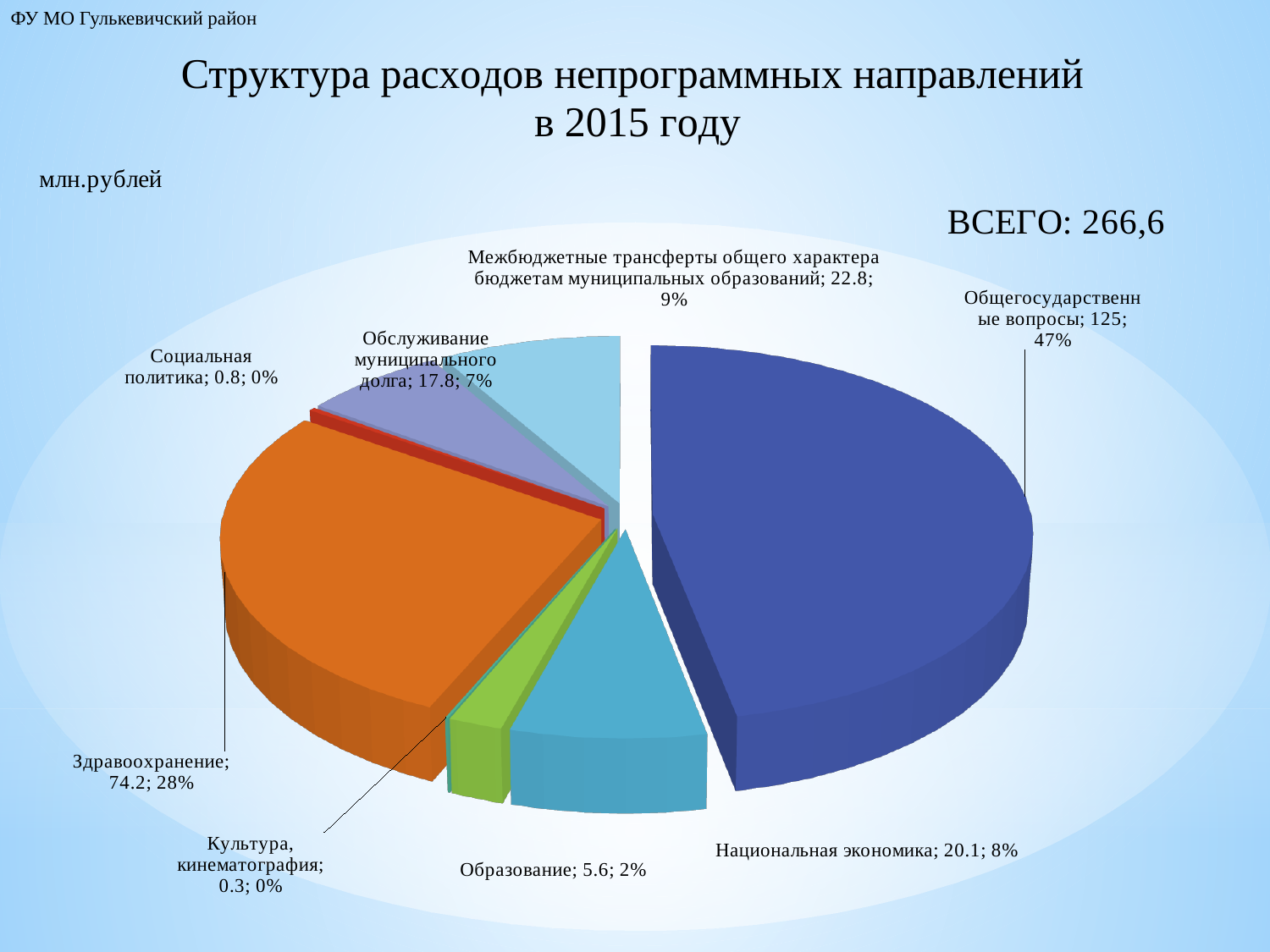
Which is larger, the value for Образование or the value for Социальная политика? Образование What share of the pie does Межбюджетные трансферты общего характера бюджетам муниципальных образований represent? 9% How many categories are shown in the pie chart? 8 What is the value for Здравоохранение? 74.2 Which category has the largest slice of the pie? Общегосударственные вопросы What is the value for Национальная экономика? 20.1 What is the value for Общегосударственные вопросы? 125 What total (ВСЕГО) is stated on the slide? 266,6 What share of the pie does Обслуживание муниципального долга represent? 7% What kind of chart is shown on the slide? pie chart Which category has the smallest value in the pie? Культура, кинематография What is the difference between the values for Здравоохранение and Национальная экономика? 54.1